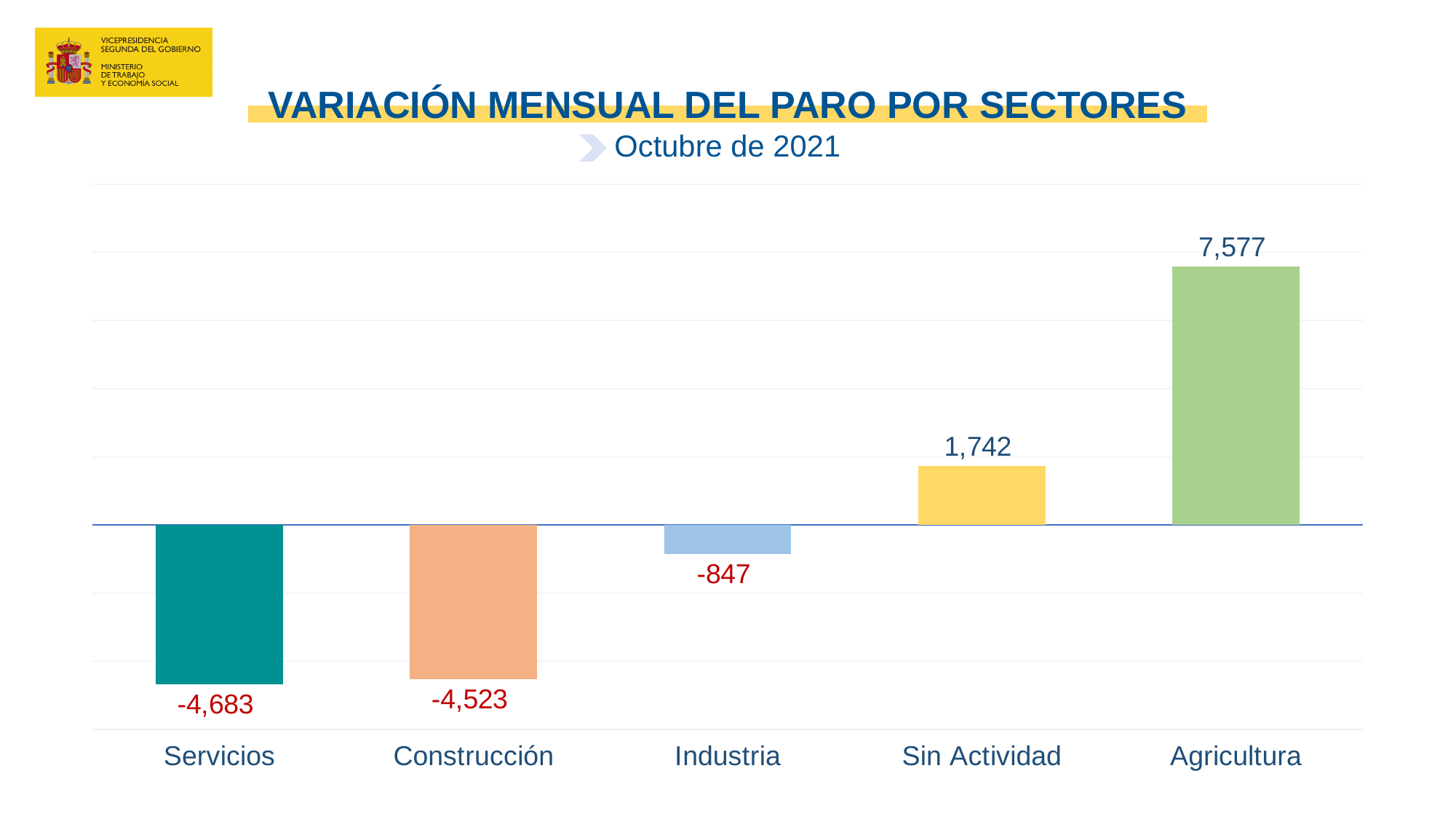
What is the difference between the values for Servicios and Construcción? 160 What is the difference between the values for Agricultura and Sin Actividad? 5,835 Which sector has the lowest value? Servicios What is the value for Industria? -847 How many sectors are shown in the chart? 5 Which sector has the highest value? Agricultura What is the value for Servicios? -4,683 What is the value for Agricultura? 7,577 What is the value for Sin Actividad? 1,742 What kind of chart is shown on the slide? Bar chart What month and year does the chart refer to? Octubre de 2021 Which is larger, the value for Sin Actividad or the value for Industria? Sin Actividad